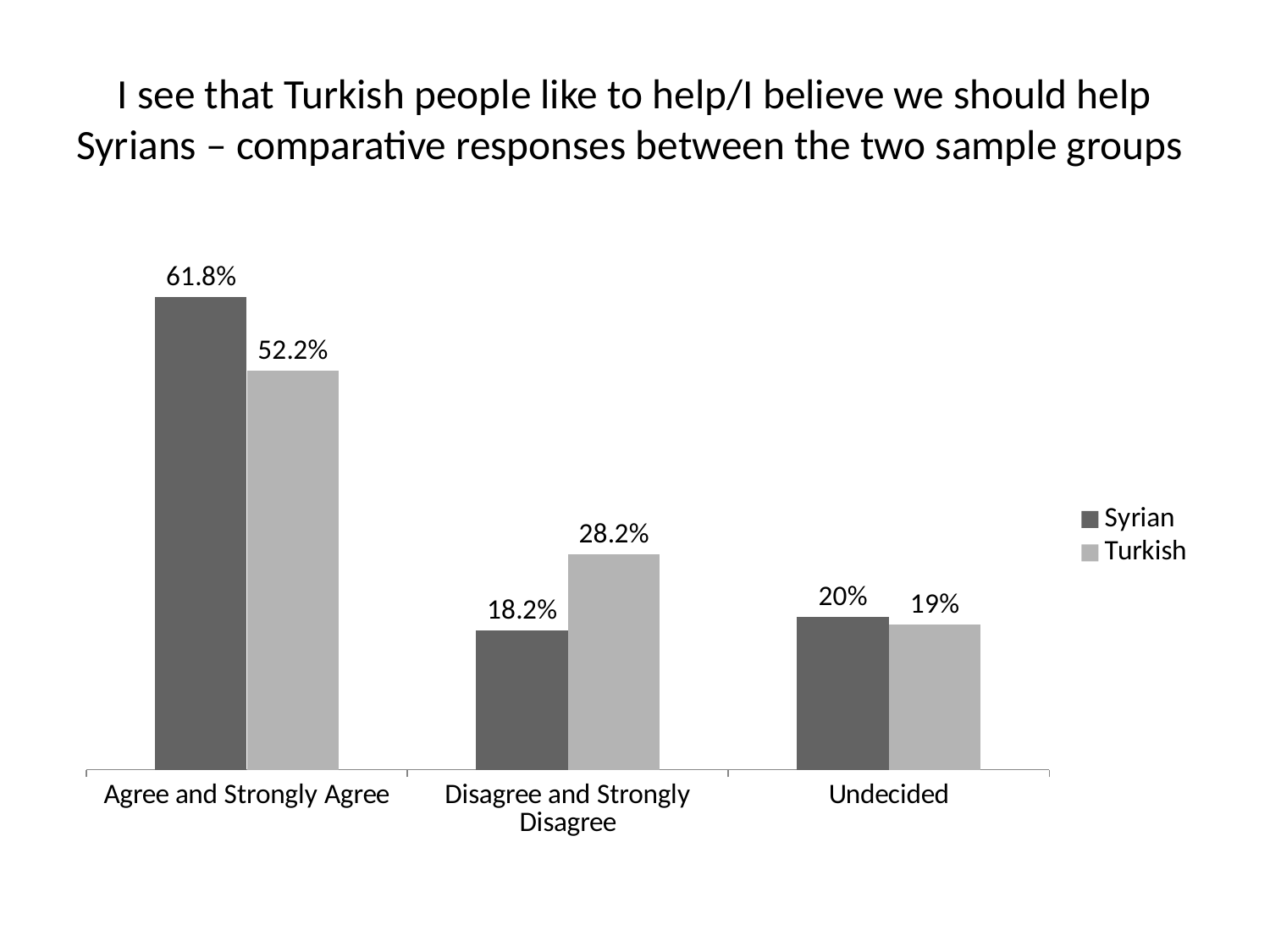
For Disagree and Strongly Disagree, which group has the larger value, Syrian or Turkish? Turkish What is the Syrian value for Agree and Strongly Agree? 61.8% What is the difference between the Turkish and Syrian values for Disagree and Strongly Disagree? 10% How many categories are shown on the x axis? 3 What is the Turkish value for Disagree and Strongly Disagree? 28.2% Which category has the highest Syrian value? Agree and Strongly Agree What is the difference between the Syrian and Turkish values for Agree and Strongly Agree? 9.6% What is the Turkish value for Undecided? 19% Which category has the lowest Turkish value? Undecided What kind of chart is shown on the slide? Bar chart What is the Syrian value for Disagree and Strongly Disagree? 18.2% How many series does the legend list? 2